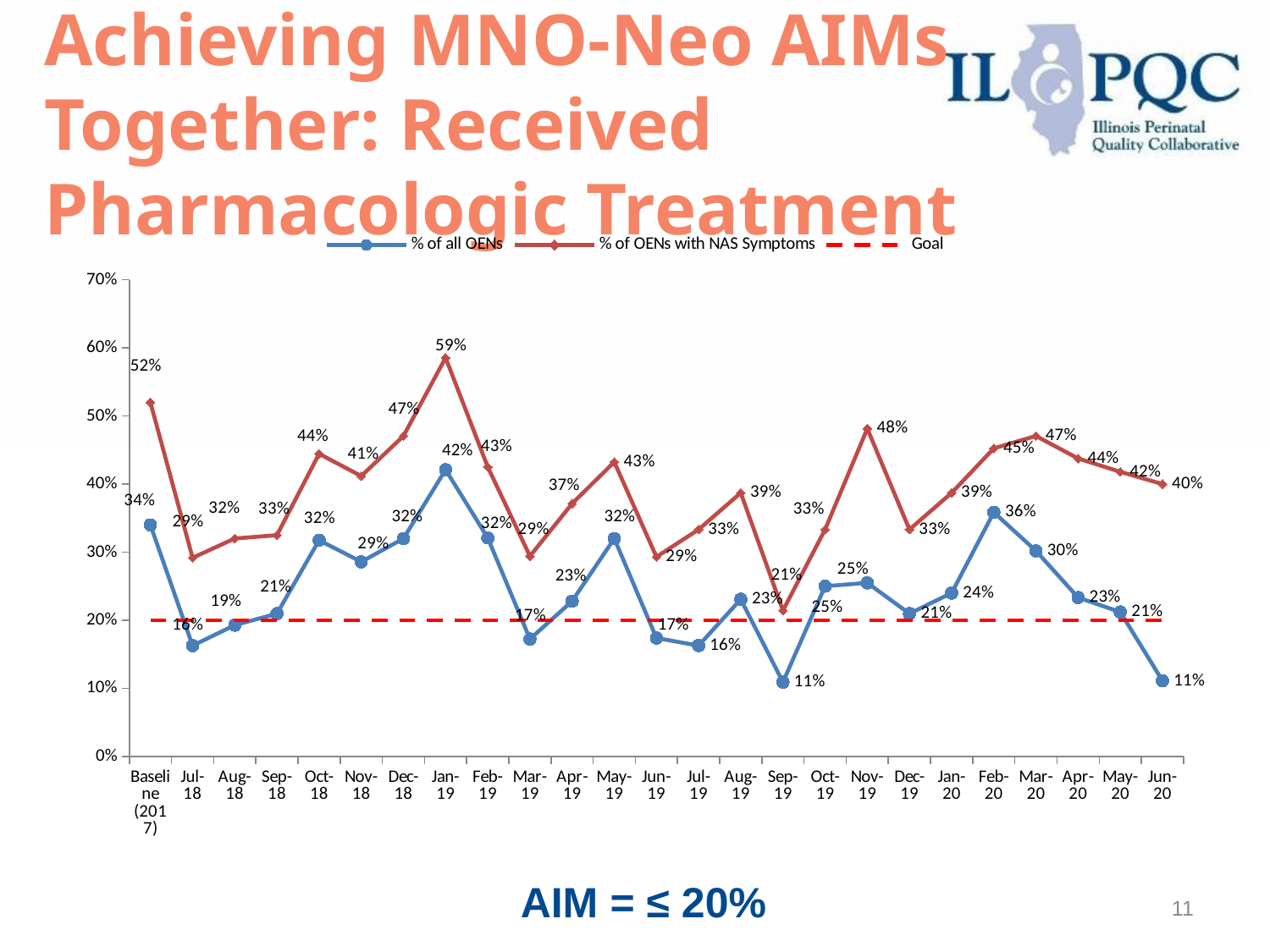
How many time points are plotted along the x axis? 25 What is the difference between the % of OENs with NAS Symptoms and the % of all OENs in Jan-19? 17 percentage points In which month is the % of OENs with NAS Symptoms lowest? Sep-19 At what value is the Goal line drawn? 20% What is the % of OENs with NAS Symptoms for Jan-19? 59% How many series does the legend list? 3 What kind of chart is shown on the slide? Line chart What is the % of all OENs for Jun-20? 11% What is the % of all OENs at Baseline (2017)? 34% Which is larger, the % of all OENs in Feb-20 or in Mar-20? Feb-20 In which month is the % of OENs with NAS Symptoms highest? Jan-19 In which month is the % of all OENs highest? Jan-19